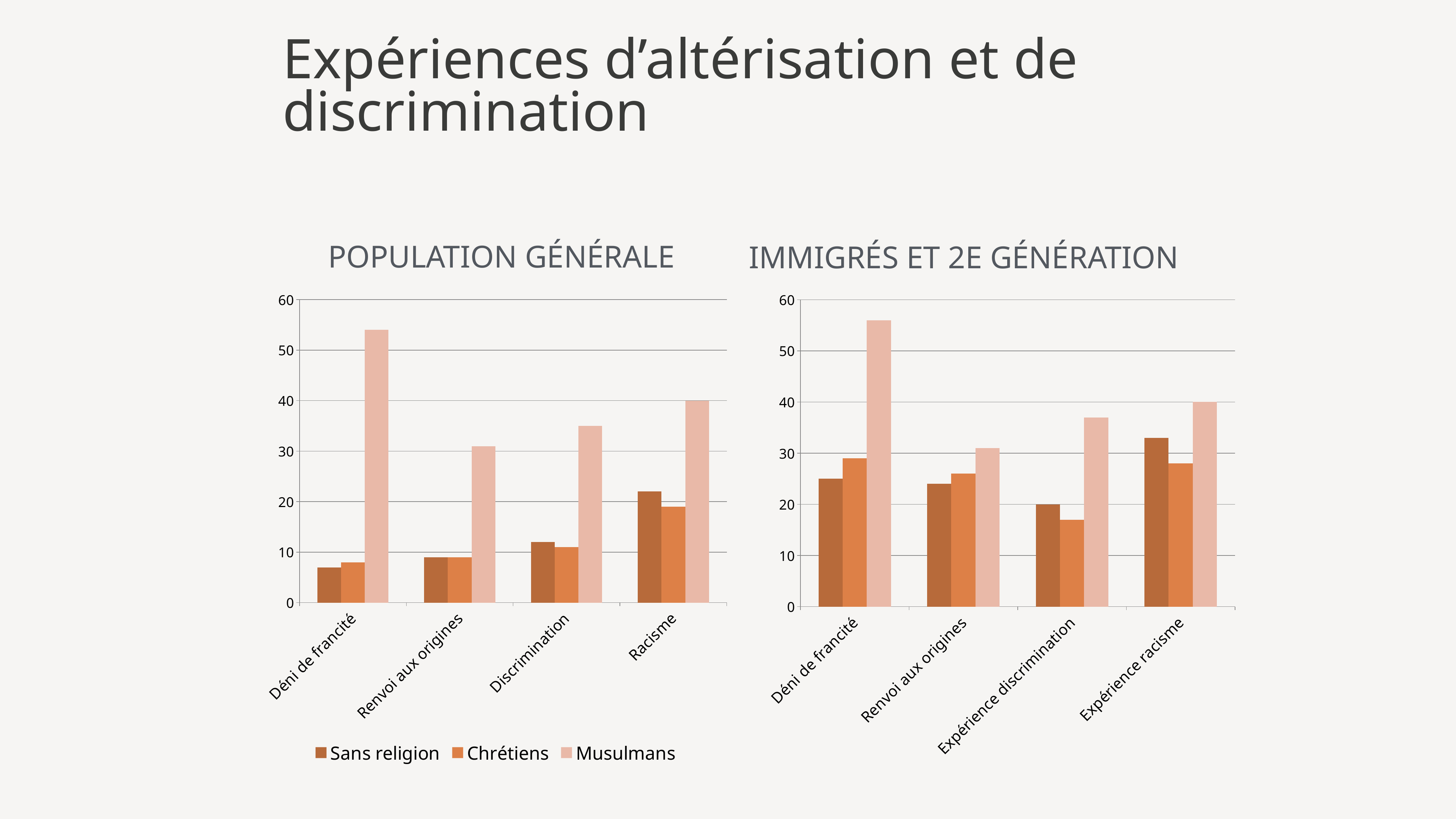
In the 'Population générale' chart, which category has the lowest value for Sans religion? Déni de francité In the 'Immigrés et 2e génération' chart, which is larger at 'Expérience racisme': Sans religion or Chrétiens? Sans religion Which series is shown in the lightest colour in the legend? Musulmans In the 'Population générale' chart, is the value for Musulmans at 'Déni de francité' greater or less than 50? greater What kind of chart is the 'Population générale' chart? bar chart How many categories are shown on the x axis of the 'Immigrés et 2e génération' chart? 4 In the 'Immigrés et 2e génération' chart, is the value for Chrétiens at 'Expérience discrimination' greater or less than 20? less In the 'Immigrés et 2e génération' chart, is the value for Musulmans at 'Déni de francité' greater or less than 50? greater In the 'Immigrés et 2e génération' chart, which category has the lowest value for Chrétiens? Expérience discrimination How many series does the legend list? 3 In the 'Population générale' chart, which category has the highest value for Musulmans? Déni de francité